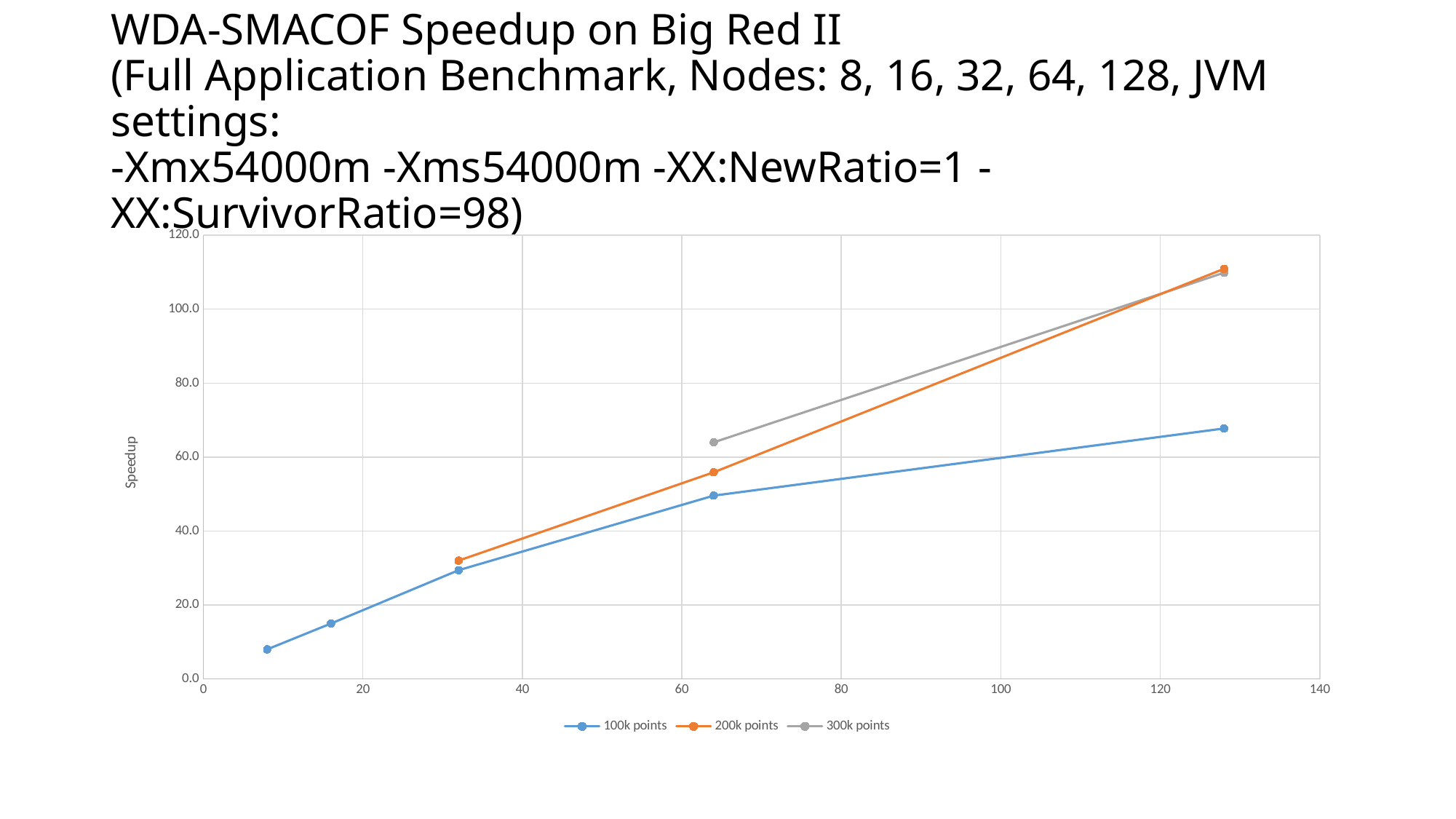
Does the speedup for the 100k points series rise or fall as the number of nodes increases? rise How many data points are plotted for the 300k points series? 2 What is the label on the vertical axis? Speedup Is the speedup for the 200k points series at 128 nodes greater or less than 100? greater At 64 nodes, which series has the higher speedup: 100k points or 300k points? 300k points Is the speedup for the 100k points series at 128 nodes greater or less than 60? greater How many data points are plotted for the 100k points series? 5 Is the speedup for the 100k points series at 64 nodes greater or less than 60? less What kind of chart is shown on the slide? line chart How many series does the legend list? 3 Which series has the highest speedup at 64 nodes? 300k points